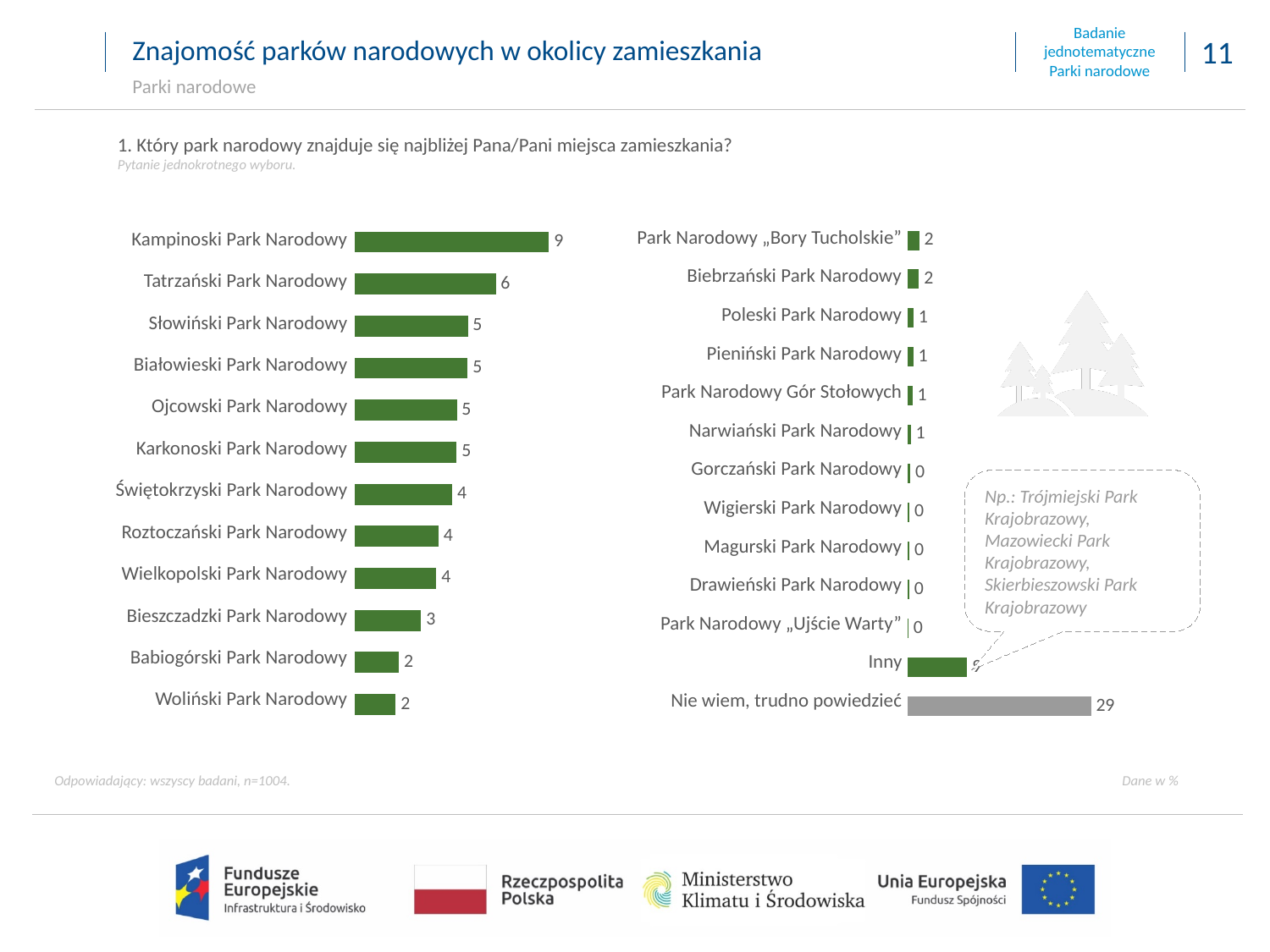
In the right chart, what is the value for Gorczański Park Narodowy? 0 In the left chart, what is the value for Tatrzański Park Narodowy? 6 In the right chart, what is the value for Biebrzański Park Narodowy? 2 In the right chart, which category has the highest value? Nie wiem, trudno powiedzieć In the left chart, what is the value for Kampinoski Park Narodowy? 9 In the left chart, which is larger: Świętokrzyski Park Narodowy or Babiogórski Park Narodowy? Świętokrzyski Park Narodowy In the left chart, what is the value for Bieszczadzki Park Narodowy? 3 In the left chart, which category has the highest value? Kampinoski Park Narodowy In the right chart, what is the value for Nie wiem, trudno powiedzieć? 29 In the left chart, what is the difference between Kampinoski Park Narodowy and Tatrzański Park Narodowy? 3 How many categories are shown in the left chart? 12 What kind of chart is the left chart? bar chart